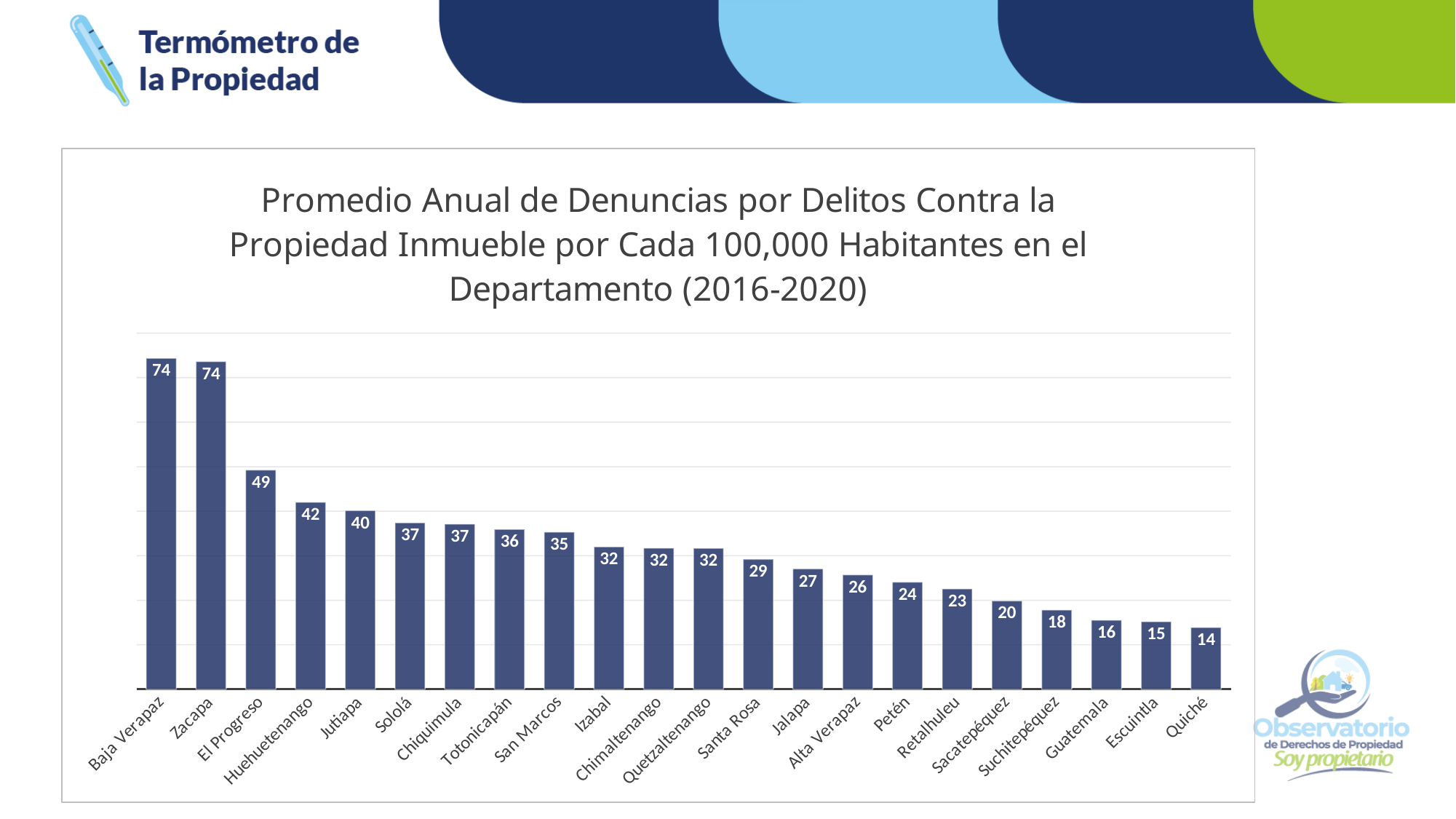
How many departments are shown in the chart? 22 Which department has the lowest value? Quiché What is the value for Santa Rosa? 29 What is the difference between the values for Huehuetenango and Jutiapa? 2 What is the value for El Progreso? 49 What kind of chart is shown on the slide? Bar chart Which is larger, the value for Jalapa or the value for Retalhuleu? Jalapa Do the values rise or fall from left to right along the x axis? Fall What is the value for Guatemala? 16 What is the value for Petén? 24 What is the difference between the values for Zacapa and Quiché? 60 Which is larger, the value for Sacatepéquez or the value for Escuintla? Sacatepéquez